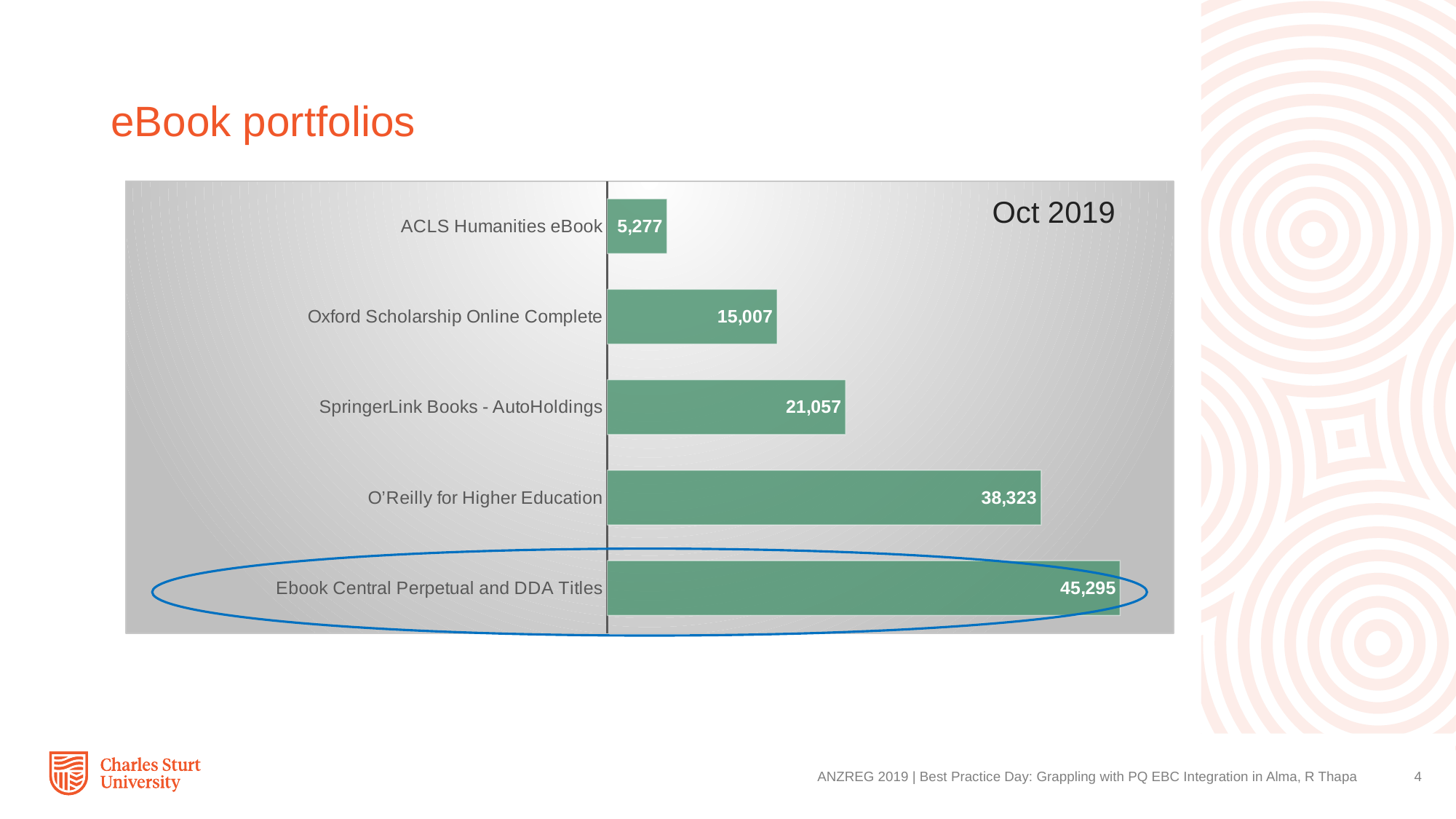
What date label is shown in the top right corner of the chart? Oct 2019 What is the difference between the values for Ebook Central Perpetual and DDA Titles and O'Reilly for Higher Education? 6,972 Which category has the lowest value? ACLS Humanities eBook What kind of chart is shown on the slide? Bar chart What is the value for Oxford Scholarship Online Complete? 15,007 What is the value for O'Reilly for Higher Education? 38,323 What is the value for ACLS Humanities eBook? 5,277 What is the value for Ebook Central Perpetual and DDA Titles? 45,295 Which is larger, the value for SpringerLink Books - AutoHoldings or Oxford Scholarship Online Complete? SpringerLink Books - AutoHoldings What is the value for SpringerLink Books - AutoHoldings? 21,057 Which category has the highest value? Ebook Central Perpetual and DDA Titles How many categories are shown in the chart? 5